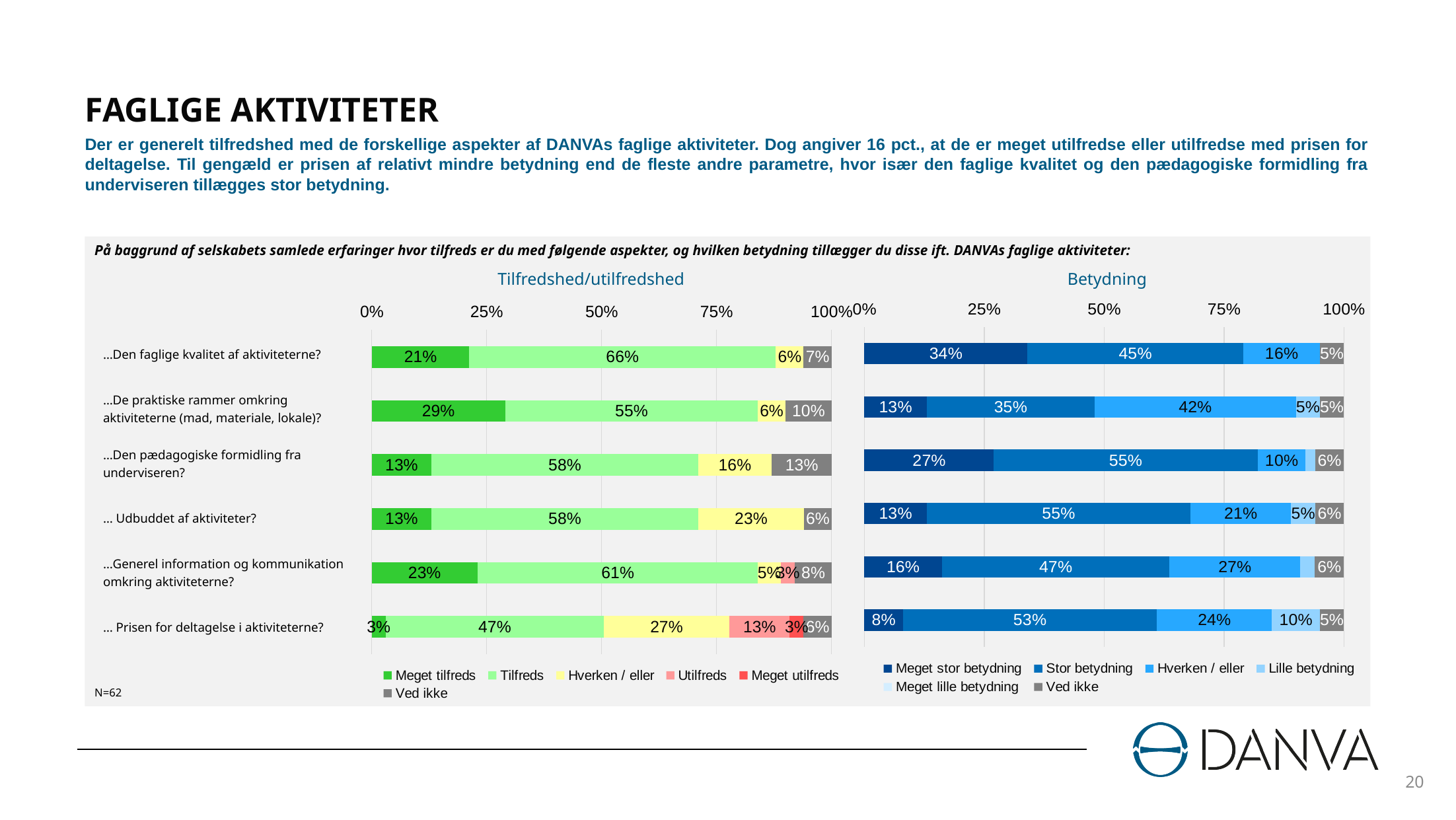
In the Tilfredshed/utilfredshed chart, which aspect has the highest Meget tilfreds share? De praktiske rammer omkring aktiviteterne (mad, materiale, lokale) In the Tilfredshed/utilfredshed chart, what percentage answered Tilfreds for "Den faglige kvalitet af aktiviteterne?" 66% What kind of chart is the Betydning chart? Stacked bar chart In the Tilfredshed/utilfredshed chart, what is the Utilfreds share for "Prisen for deltagelse i aktiviteterne?" 13% In the Tilfredshed/utilfredshed chart, what is the Meget tilfreds share for "De praktiske rammer omkring aktiviteterne (mad, materiale, lokale)?" 29% In the Betydning chart, what is the Hverken / eller share for "De praktiske rammer omkring aktiviteterne (mad, materiale, lokale)?" 42% In the Betydning chart, what is the Stor betydning share for "Den pædagogiske formidling fra underviseren?" 55% In the Tilfredshed/utilfredshed chart, how much higher is the Tilfreds share for "Den faglige kvalitet af aktiviteterne?" than for "Prisen for deltagelse i aktiviteterne?" 19 percentage points In the Betydning chart, what is the Meget stor betydning share for "Den faglige kvalitet af aktiviteterne?" 34% How many series does the legend of the Tilfredshed/utilfredshed chart list? 6 How many aspects (categories) are shown in the Tilfredshed/utilfredshed chart? 6 In the Betydning chart, which aspect has the lowest Meget stor betydning share? Prisen for deltagelse i aktiviteterne